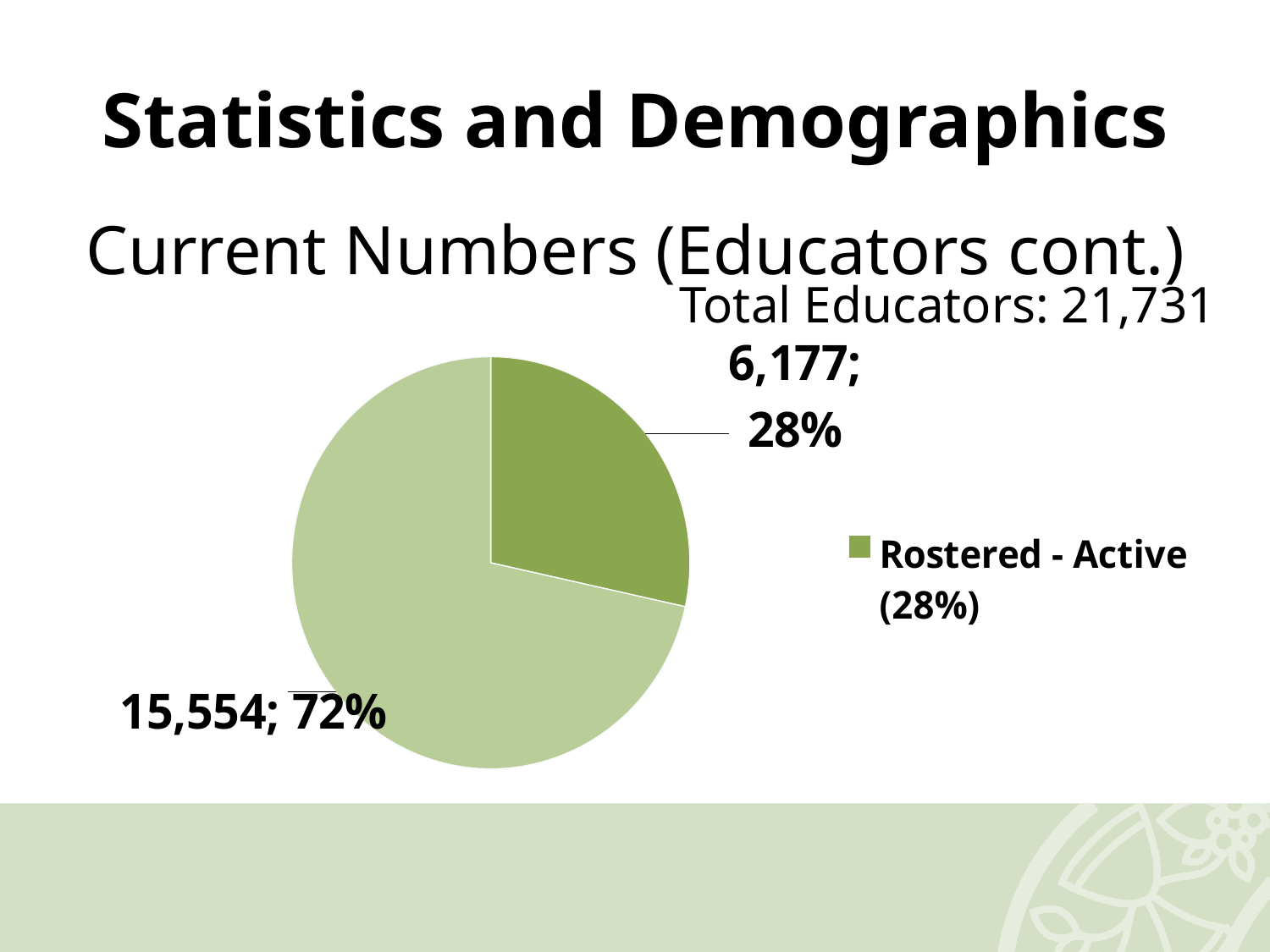
What is the total of the two slices in the pie chart? 21,731 What is the text of the legend entry? Rostered - Active (28%) What percentage is shown on the larger slice of the pie? 72% What value is shown on the larger slice of the pie? 15,554 Is the Rostered - Active slice larger or smaller than the other slice? smaller What share of the pie does the Rostered - Active slice represent? 28% What kind of chart is shown on the slide? pie chart Is the Rostered - Active slice the largest or the smallest slice of the pie? smallest How many entries does the legend list? 1 What is the difference between the larger slice (15,554) and the Rostered - Active slice? 9,377 What value is shown for the Rostered - Active slice? 6,177 How many slices does the pie chart have? 2